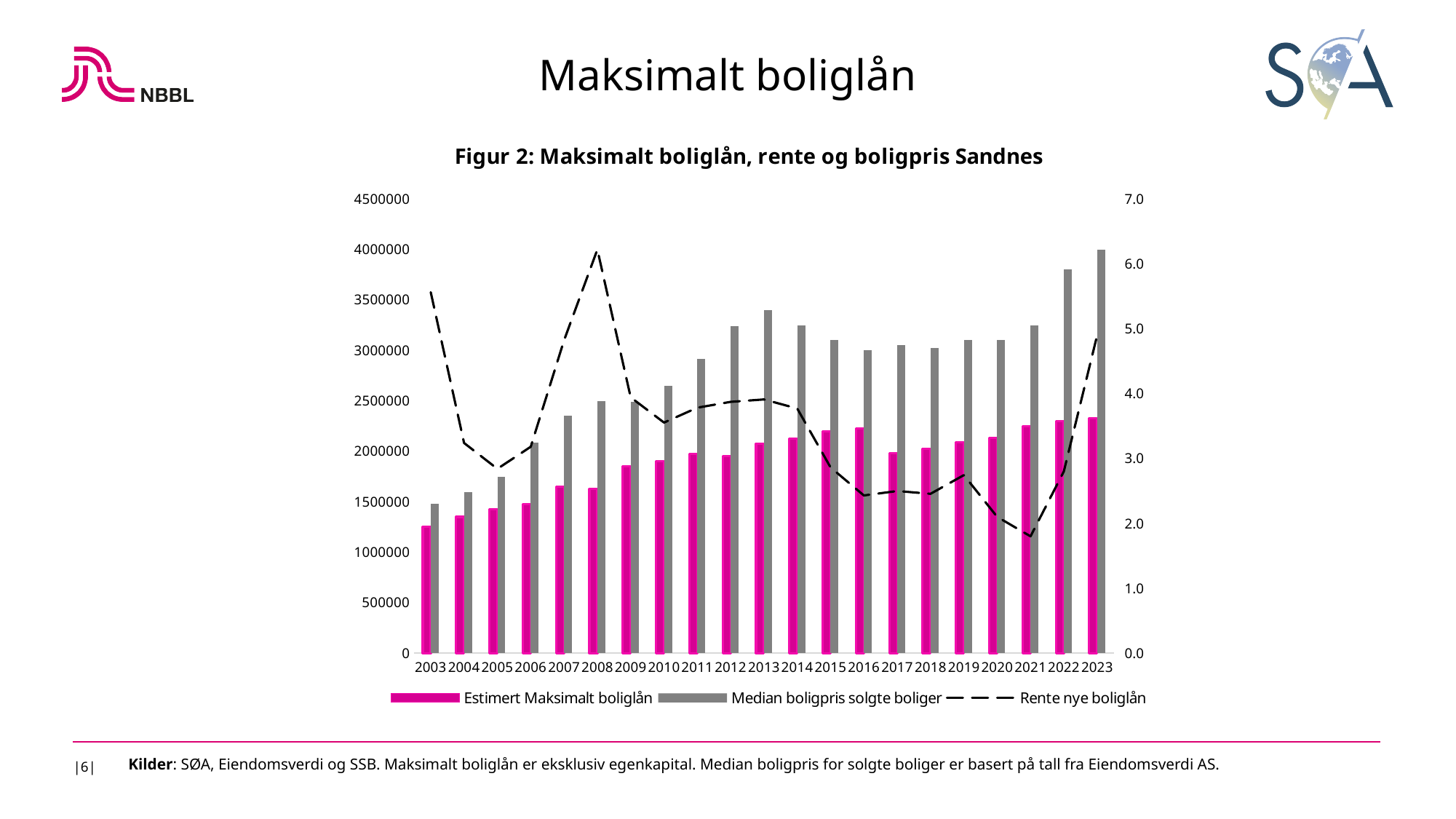
In which year does Rente nye boliglån reach its highest value? 2008 What is the title of the chart? Figur 2: Maksimalt boliglån, rente og boligpris Sandnes How many years are shown on the x axis of the chart? 21 In which year is Rente nye boliglån at its lowest? 2021 How many series does the legend of the chart list? 3 Is the value of Rente nye boliglån in 2021 greater or less than 2.0? less Is the value of Median boligpris solgte boliger in 2022 greater or less than 3500000? greater In which year is Estimert Maksimalt boliglån lowest? 2003 Does Estimert Maksimalt boliglån rise or fall from 2003 to 2013? rise Which series is drawn as a dashed line in the chart? Rente nye boliglån What kind of chart is shown in Figur 2? A combined bar and line chart In which year is Median boligpris solgte boliger highest? 2023